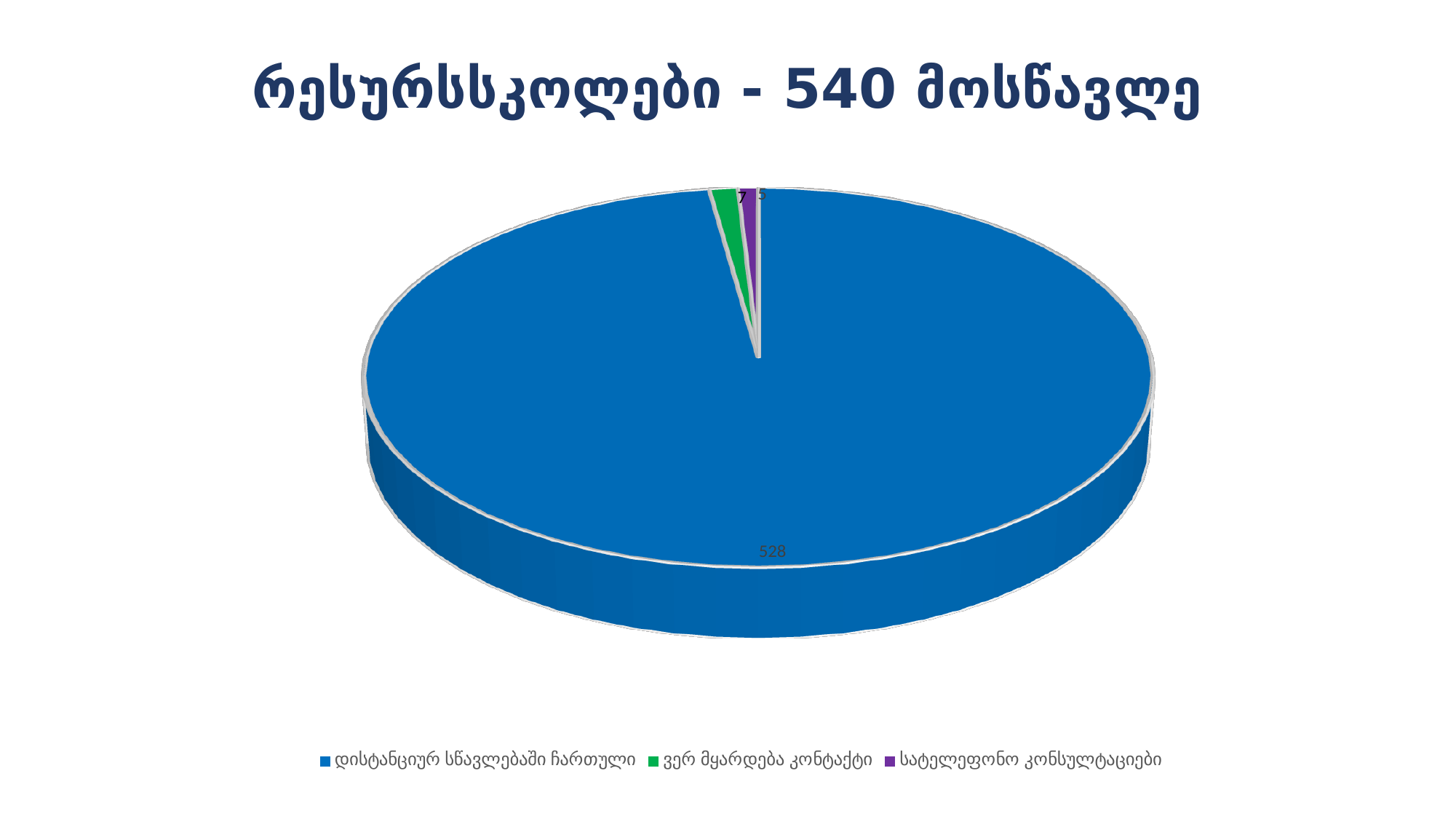
What is the difference between the values for დისტანციურ სწავლებაში ჩართული and ვერ მყარდება კონტაქტი? 521 Which category has the smallest slice of the pie? სატელეფონო კონსულტაციები Which is larger, the value for ვერ მყარდება კონტაქტი or the value for სატელეფონო კონსულტაციები? ვერ მყარდება კონტაქტი What type of chart is shown on the slide? pie chart What colour is the slice for სატელეფონო კონსულტაციები? purple What is the difference between the values for ვერ მყარდება კონტაქტი and სატელეფონო კონსულტაციები? 2 What is the value for სატელეფონო კონსულტაციები? 5 What is the value for ვერ მყარდება კონტაქტი? 7 What is the total of all the slices in the pie chart? 540 How many categories does the pie chart have? 3 What is the value for დისტანციურ სწავლებაში ჩართული? 528 Which category has the largest slice of the pie? დისტანციურ სწავლებაში ჩართული